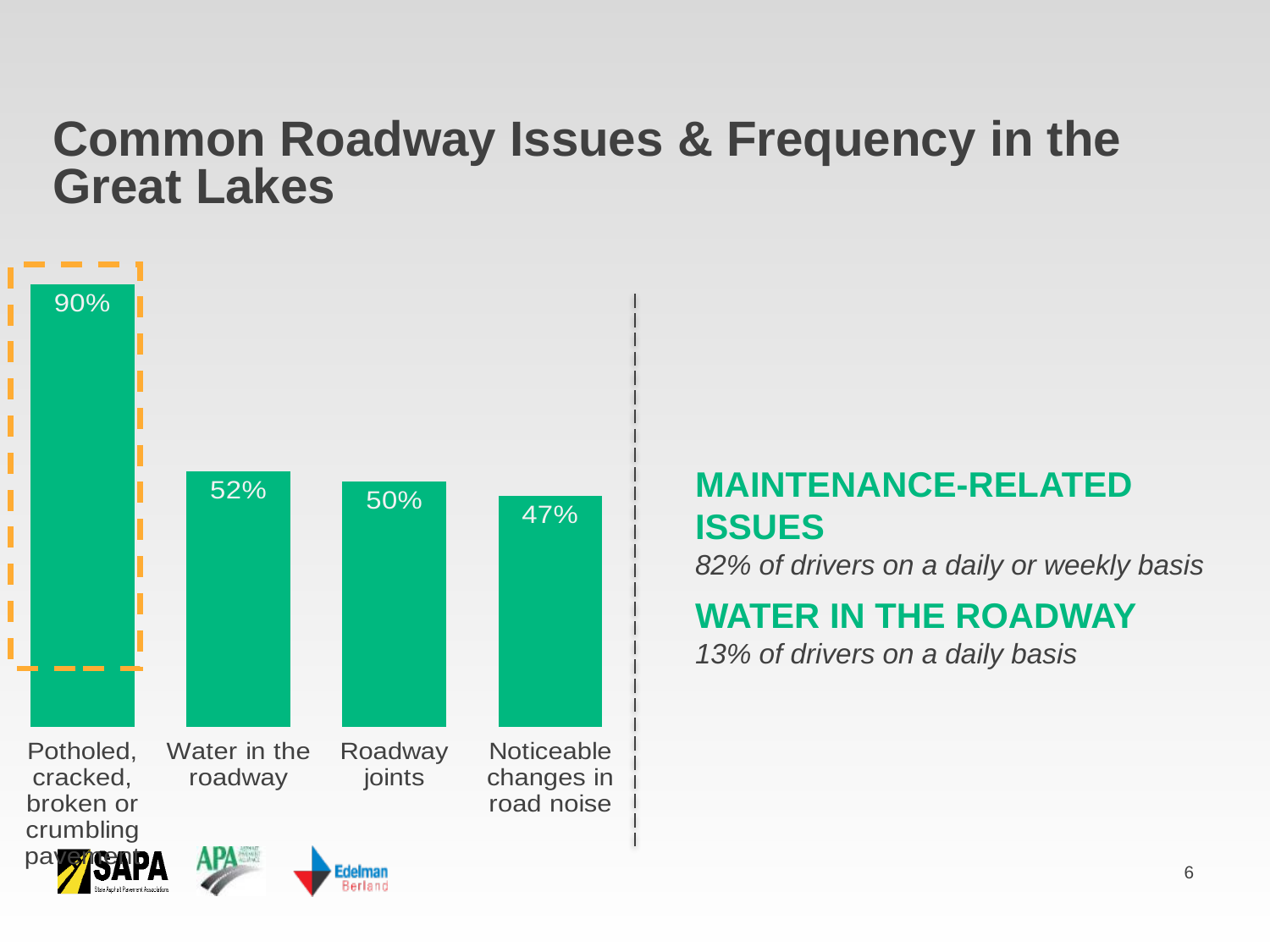
What is the value for Roadway joints? 50% What is the value for Water in the roadway? 52% Which category has the lowest value? Noticeable changes in road noise What is the value for Potholed, cracked, broken or crumbling pavement? 90% What is the value for Noticeable changes in road noise? 47% What kind of chart is shown on the slide? Bar chart Which bar is highlighted with a dashed orange outline? Potholed, cracked, broken or crumbling pavement Which is larger, the value for Water in the roadway or the value for Noticeable changes in road noise? Water in the roadway Which category has the highest value? Potholed, cracked, broken or crumbling pavement What is the difference between the values for Roadway joints and Noticeable changes in road noise? 3% What is the difference between the values for Potholed, cracked, broken or crumbling pavement and Water in the roadway? 38% How many categories are shown in the chart? 4